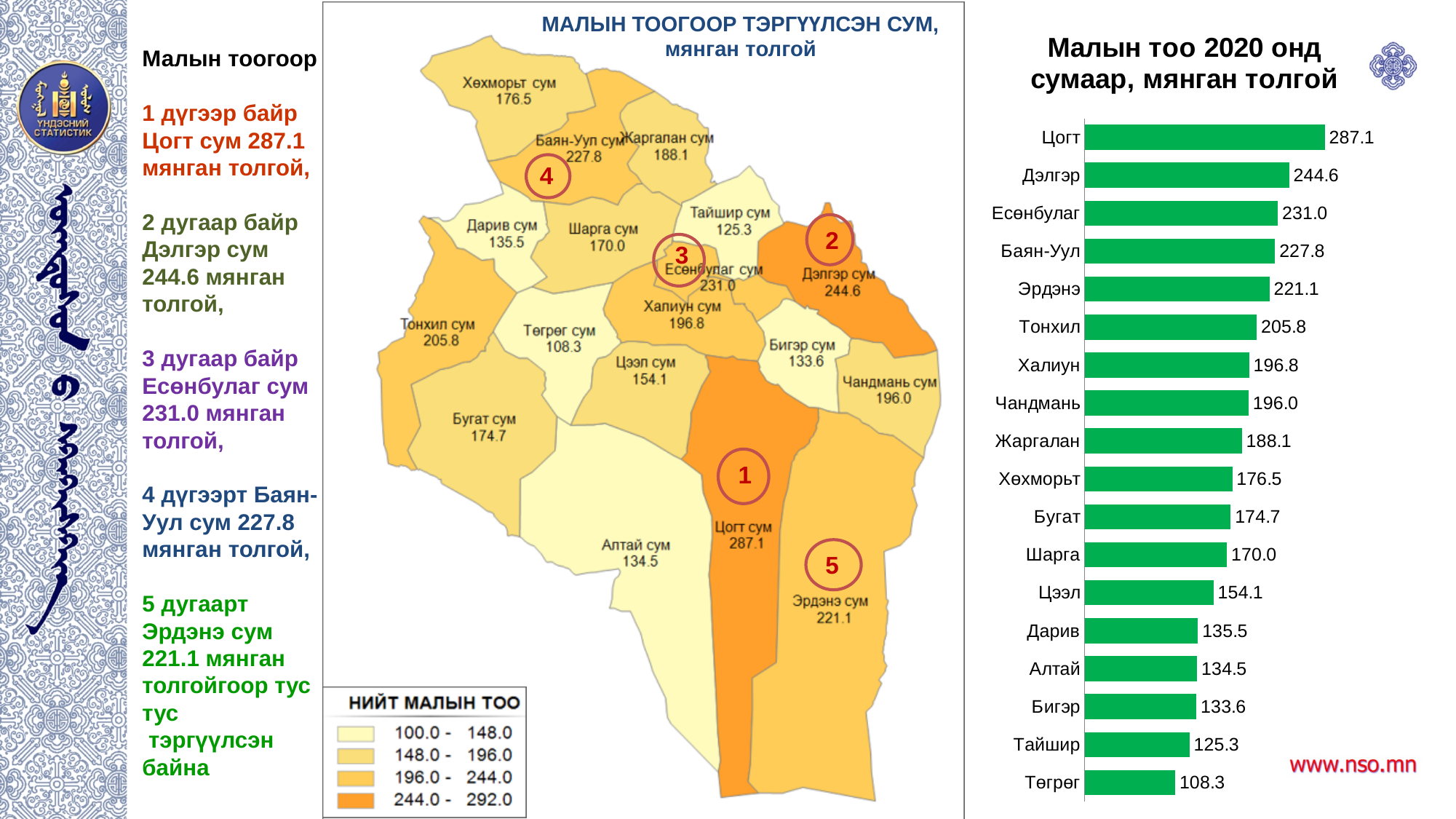
What colour are the bars in the bar chart 'Малын тоо 2020 онд сумаар, мянган толгой'? Green In the bar chart 'Малын тоо 2020 онд сумаар, мянган толгой', what is the difference between the values for Цогт and Дэлгэр? 42.5 In the bar chart 'Малын тоо 2020 онд сумаар, мянган толгой', what is the value for Тайшир? 125.3 In the bar chart 'Малын тоо 2020 онд сумаар, мянган толгой', which is larger, the value for Бугат or the value for Дарив? Бугат What kind of chart is 'Малын тоо 2020 онд сумаар, мянган толгой'? Bar chart In the bar chart 'Малын тоо 2020 онд сумаар, мянган толгой', what is the difference between the values for Шарга and Цээл? 15.9 In the bar chart 'Малын тоо 2020 онд сумаар, мянган толгой', which sum has the lowest value? Төгрөг How many sums (categories) are shown in the bar chart 'Малын тоо 2020 онд сумаар, мянган толгой'? 18 In the bar chart 'Малын тоо 2020 онд сумаар, мянган толгой', which is larger, the value for Эрдэнэ or the value for Баян-Уул? Баян-Уул In the bar chart 'Малын тоо 2020 онд сумаар, мянган толгой', which sum has the highest value? Цогт In the bar chart 'Малын тоо 2020 онд сумаар, мянган толгой', what is the value for Тонхил? 205.8 In the bar chart 'Малын тоо 2020 онд сумаар, мянган толгой', what is the value for Цогт? 287.1